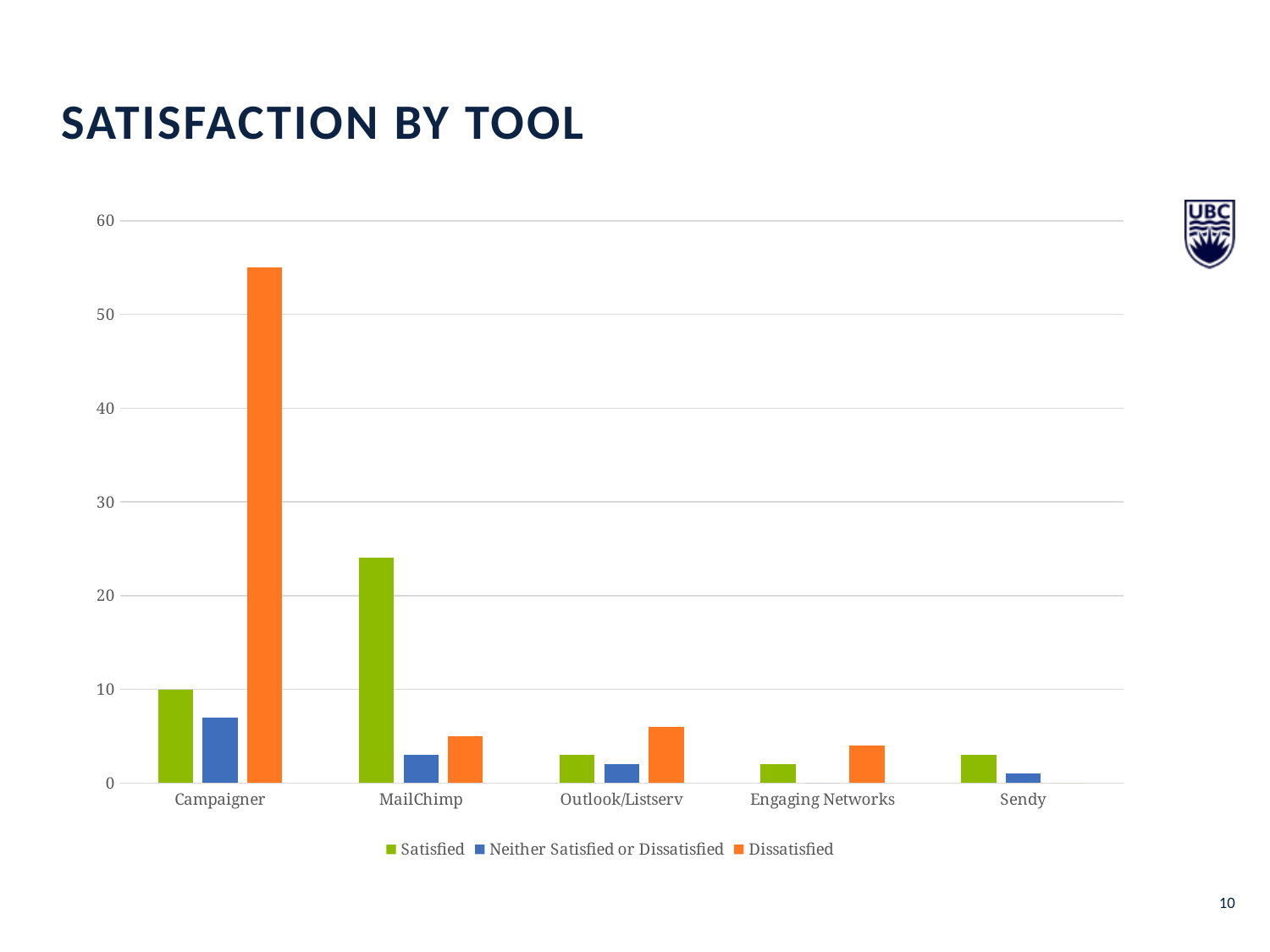
How many tools (categories) are shown on the x axis? 5 Is the Satisfied value for MailChimp greater or less than 20? greater Which tool has the highest Satisfied value? MailChimp Which is larger, the Satisfied value for MailChimp or the Satisfied value for Campaigner? MailChimp What colour represents the Dissatisfied series in the legend? orange What kind of chart is shown on the slide? bar chart Which is larger, the Dissatisfied value for Campaigner or the Dissatisfied value for MailChimp? Campaigner Which tool has the highest Dissatisfied value? Campaigner What is the title of the slide's chart? SATISFACTION BY TOOL How many series does the legend list? 3 Is the Dissatisfied value for Campaigner greater or less than 50? greater Is the Neither Satisfied or Dissatisfied value for Campaigner greater or less than 10? less